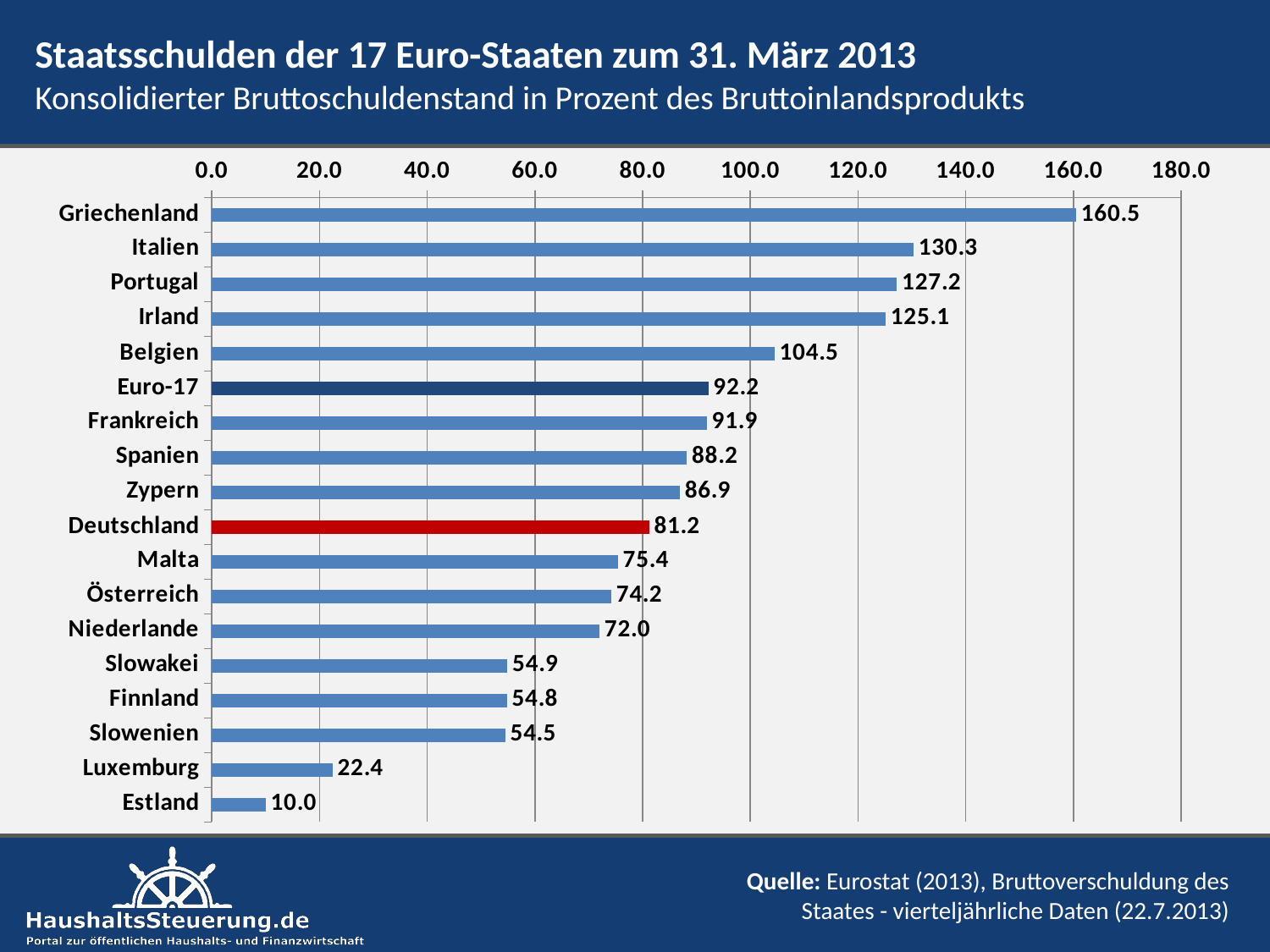
What kind of chart is shown on the slide? bar chart Which category has the highest value? Griechenland Which bar is coloured red? Deutschland How many categories are shown on the chart? 18 What is the difference between the values for Euro-17 and Deutschland? 11.0 Which is larger, the value for Portugal or the value for Irland? Portugal What is the value for Euro-17? 92.2 What is the difference between the values for Griechenland and Italien? 30.2 What is the value for Belgien? 104.5 What is the value for Deutschland? 81.2 Is the value for Belgien greater or less than 100.0? greater Which category has the lowest value? Estland